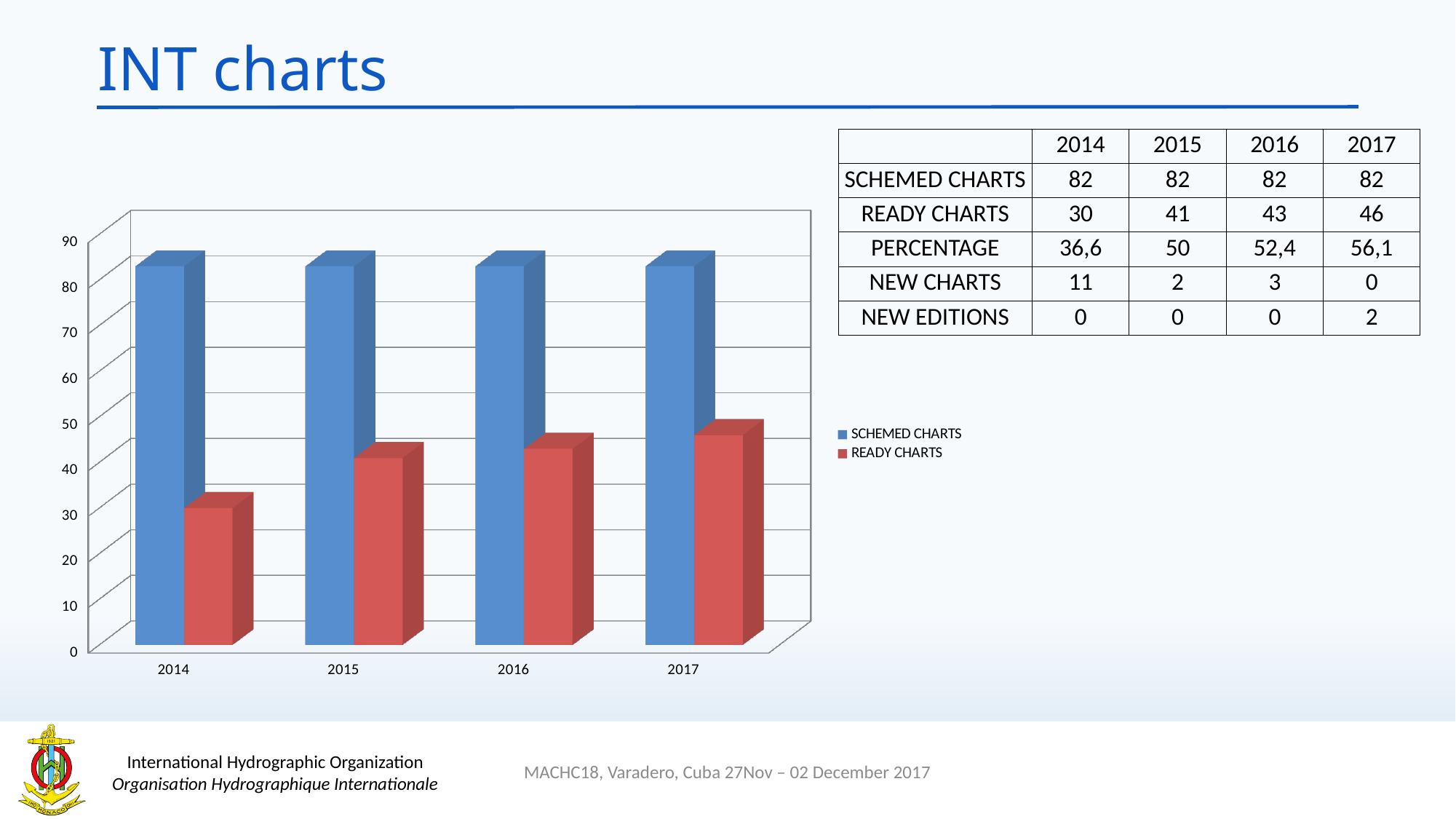
In which year is the READY CHARTS bar the highest? 2017 What is the value of READY CHARTS for 2014? 30 Is the READY CHARTS value for 2014 greater or less than 40? less What is the value of READY CHARTS for 2017? 46 In which year is the READY CHARTS bar the lowest? 2014 What is the difference between SCHEMED CHARTS and READY CHARTS in 2015? 41 Which is larger in 2016, SCHEMED CHARTS or READY CHARTS? SCHEMED CHARTS How many years are shown on the x axis of the chart? 4 What is the value of SCHEMED CHARTS for 2016? 82 What kind of chart is shown on the slide? bar chart Do the READY CHARTS values rise or fall from 2014 to 2017? rise How many series does the chart legend list? 2